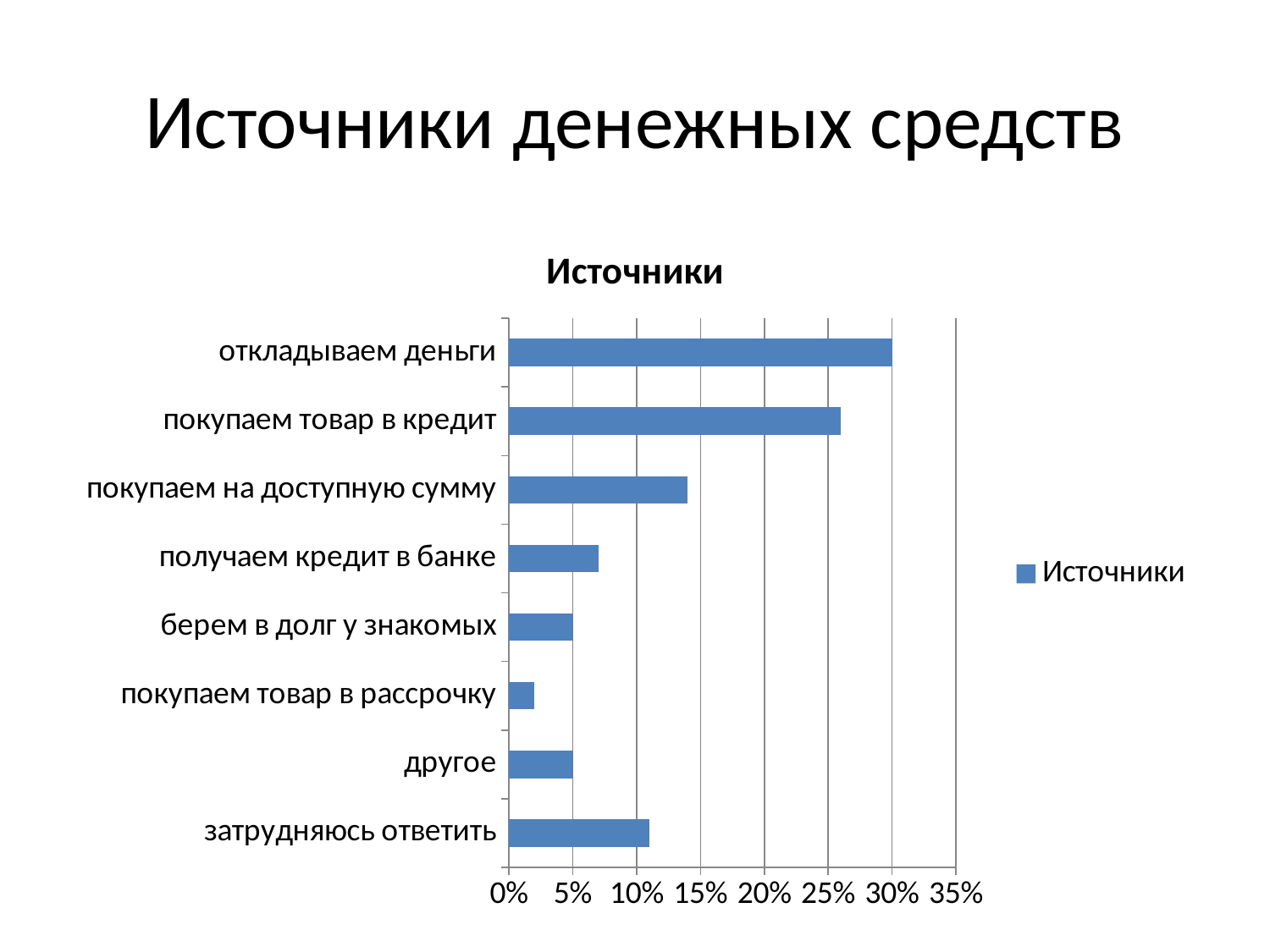
Is the value for покупаем на доступную сумму greater or less than 15%? less Is the value for покупаем товар в кредит greater or less than 25%? greater What kind of chart is shown on the slide? bar chart Which category has the highest value? откладываем деньги What is the value for откладываем деньги? 30% How many series does the legend list? 1 How many categories are plotted in the chart? 8 What is the value for берем в долг у знакомых? 5% What is the title of the chart? Источники Is the value for затрудняюсь ответить greater or less than 10%? greater Which category has the lowest value? покупаем товар в рассрочку Which is larger, the value for покупаем товар в кредит or the value for покупаем на доступную сумму? покупаем товар в кредит